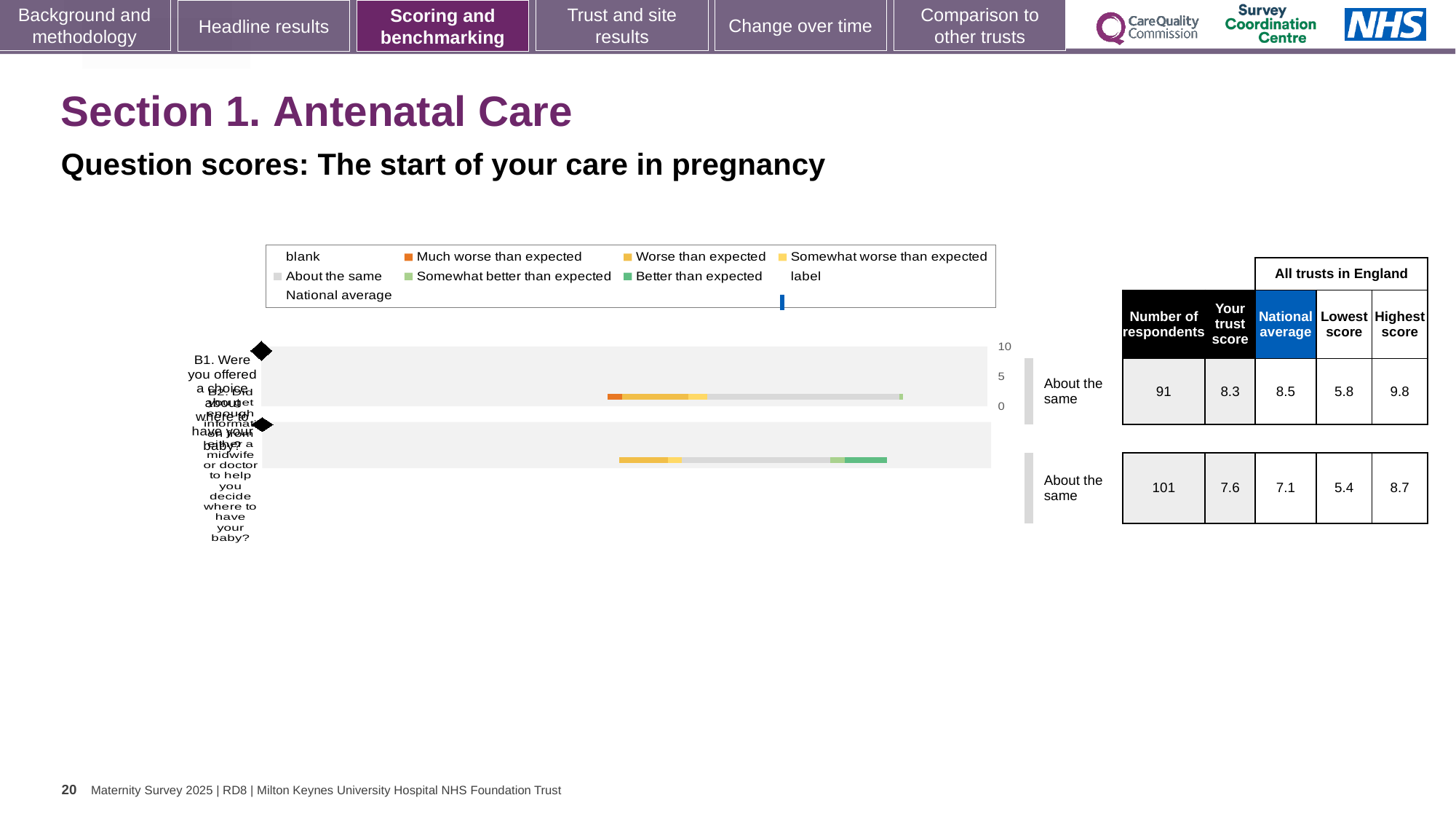
What is the national average for question B2? 7.1 For question B1, which is larger: the trust score or the national average? National average What benchmark category is shown next to the bar for question B1? About the same Which question has the higher trust score, B1 or B2? B1 How many questions (bars) are plotted in the chart? 2 What is the highest score across all trusts in England for question B1? 9.8 What is the difference between the trust score and the national average for question B2? 0.5 What is the difference between the highest and lowest score for question B2? 3.3 How many respondents answered question B2? 101 What is the 'Your trust score' value for question B1? 8.3 What colour does the legend use for 'Much worse than expected'? Orange What kind of chart is shown on the slide? bar chart